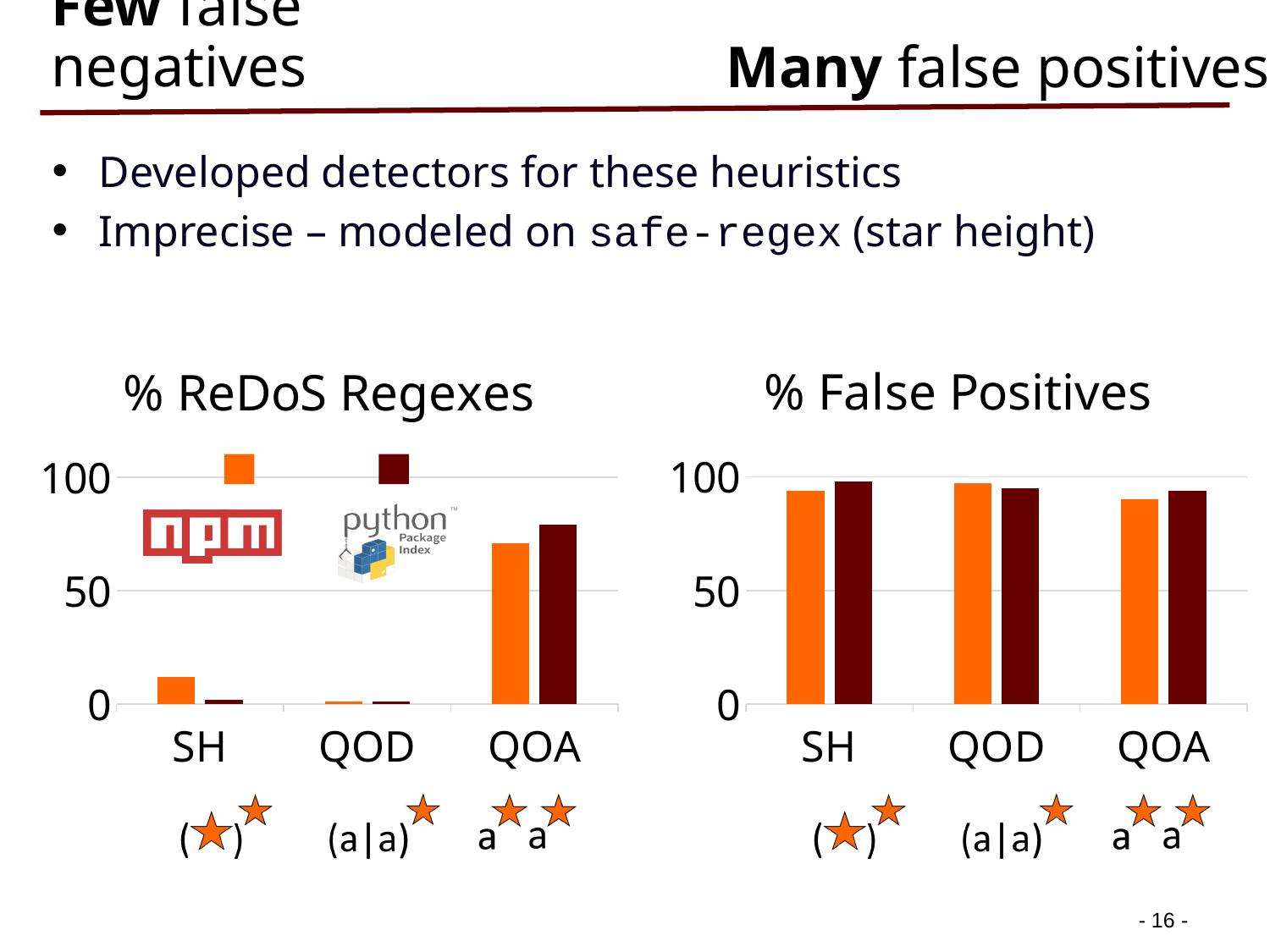
In the "% ReDoS Regexes" chart, which category has the lowest npm (orange) value? QOD Which two package registries are compared in the legend of the "% ReDoS Regexes" chart? npm and Python Package Index (PyPI) In the "% ReDoS Regexes" chart, which is larger for npm (orange): SH or QOA? QOA In the "% ReDoS Regexes" chart, which category has the highest npm (orange) value? QOA In the "% False Positives" chart, is the npm (orange) value for SH greater or less than 50? greater In the "% ReDoS Regexes" chart, for SH, which series has the larger value: npm (orange) or PyPI (dark red)? npm (orange) In the "% ReDoS Regexes" chart, is the npm (orange) value for SH greater or less than 50? less How many categories are shown on the x axis of the "% False Positives" chart? 3 What is the title of the chart on the right side of the slide? % False Positives In the "% ReDoS Regexes" chart, is the npm (orange) value for QOA greater or less than 50? greater What kind of chart is the "% ReDoS Regexes" chart? bar chart How many series does the "% ReDoS Regexes" chart plot? 2